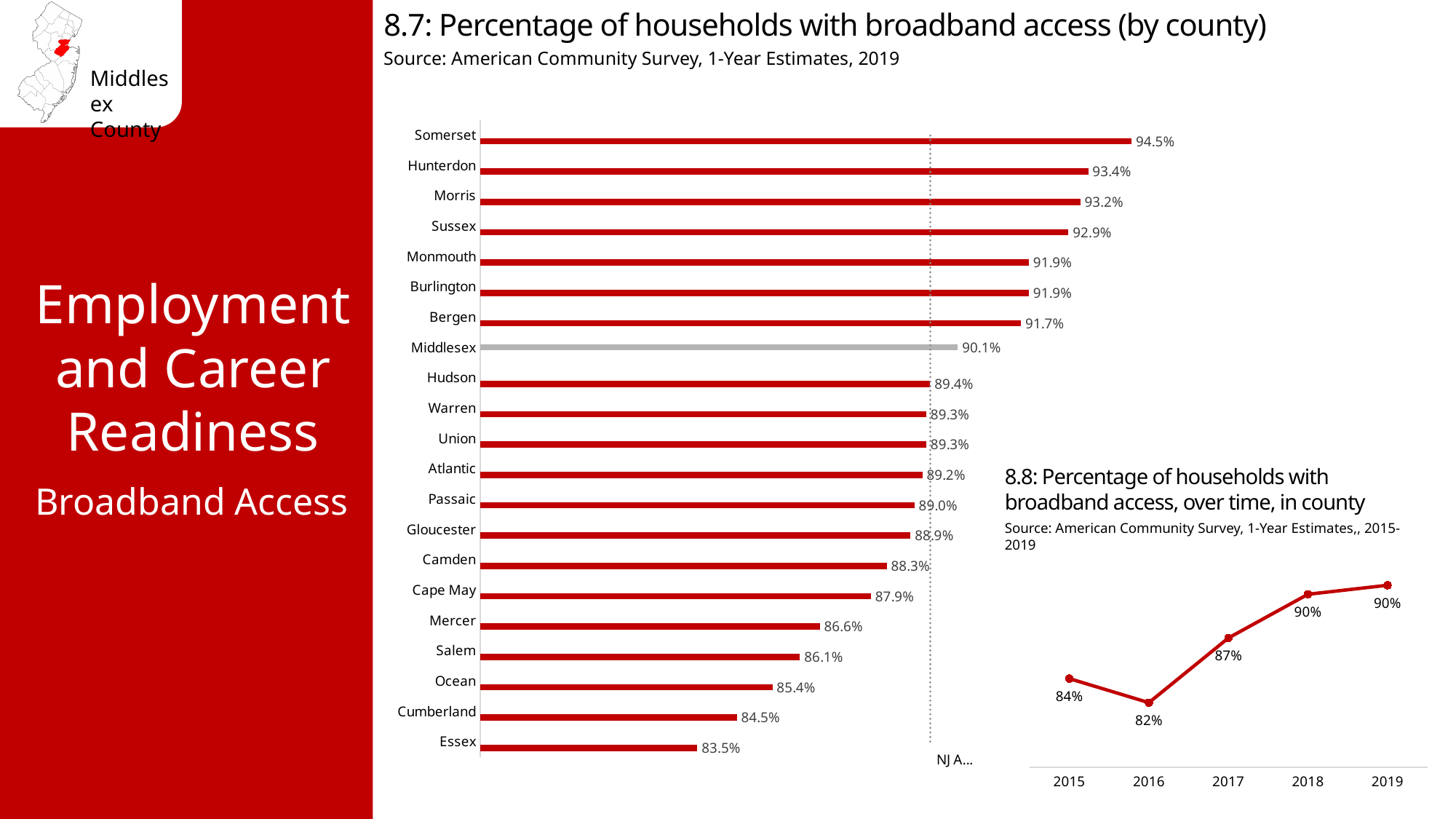
In chart 8.7, which county has the highest percentage of households with broadband access? Somerset In chart 8.7, what percentage of households in Middlesex have broadband access? 90.1% In chart 8.7, what is the value for Cumberland? 84.5% In chart 8.8, what was the percentage of households with broadband access in 2016? 82% In chart 8.8, which year has the lowest value? 2016 In chart 8.7, how many counties are shown? 21 What kind of chart is chart 8.7? Bar chart In chart 8.7, which county has the lowest percentage of households with broadband access? Essex In chart 8.8, how many years are plotted? 5 In chart 8.7, which county has a higher value, Bergen or Hudson? Bergen In chart 8.7, what is the difference in percentage points between Somerset and Essex? 11.0 In chart 8.8, do the values generally rise or fall from 2016 to 2019? Rise